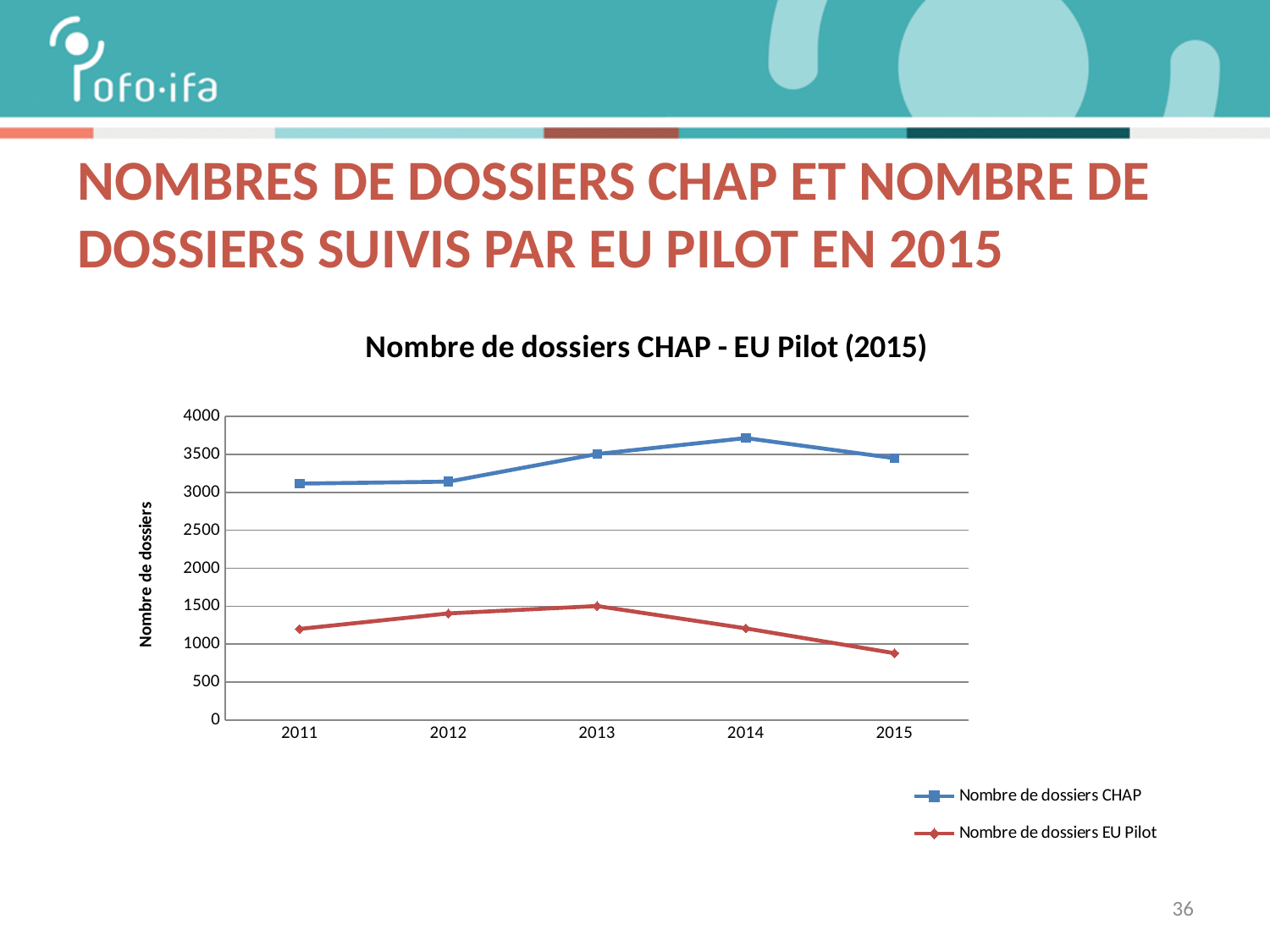
In which year is the number of CHAP dossiers highest? 2014 What type of chart is shown on the slide? line chart How many series does the legend list? 2 What is the title of the chart? Nombre de dossiers CHAP - EU Pilot (2015) Is the value for Nombre de dossiers EU Pilot in 2015 greater or less than 1000? less How many years are plotted on the x axis? 5 In which year is the number of EU Pilot dossiers lowest? 2015 Is the value for Nombre de dossiers CHAP in 2014 greater or less than 3500? greater Is the value for Nombre de dossiers CHAP in 2011 greater or less than 3000? greater Does the number of EU Pilot dossiers rise or fall from 2013 to 2015? fall In 2013, which series has the larger value, Nombre de dossiers CHAP or Nombre de dossiers EU Pilot? Nombre de dossiers CHAP